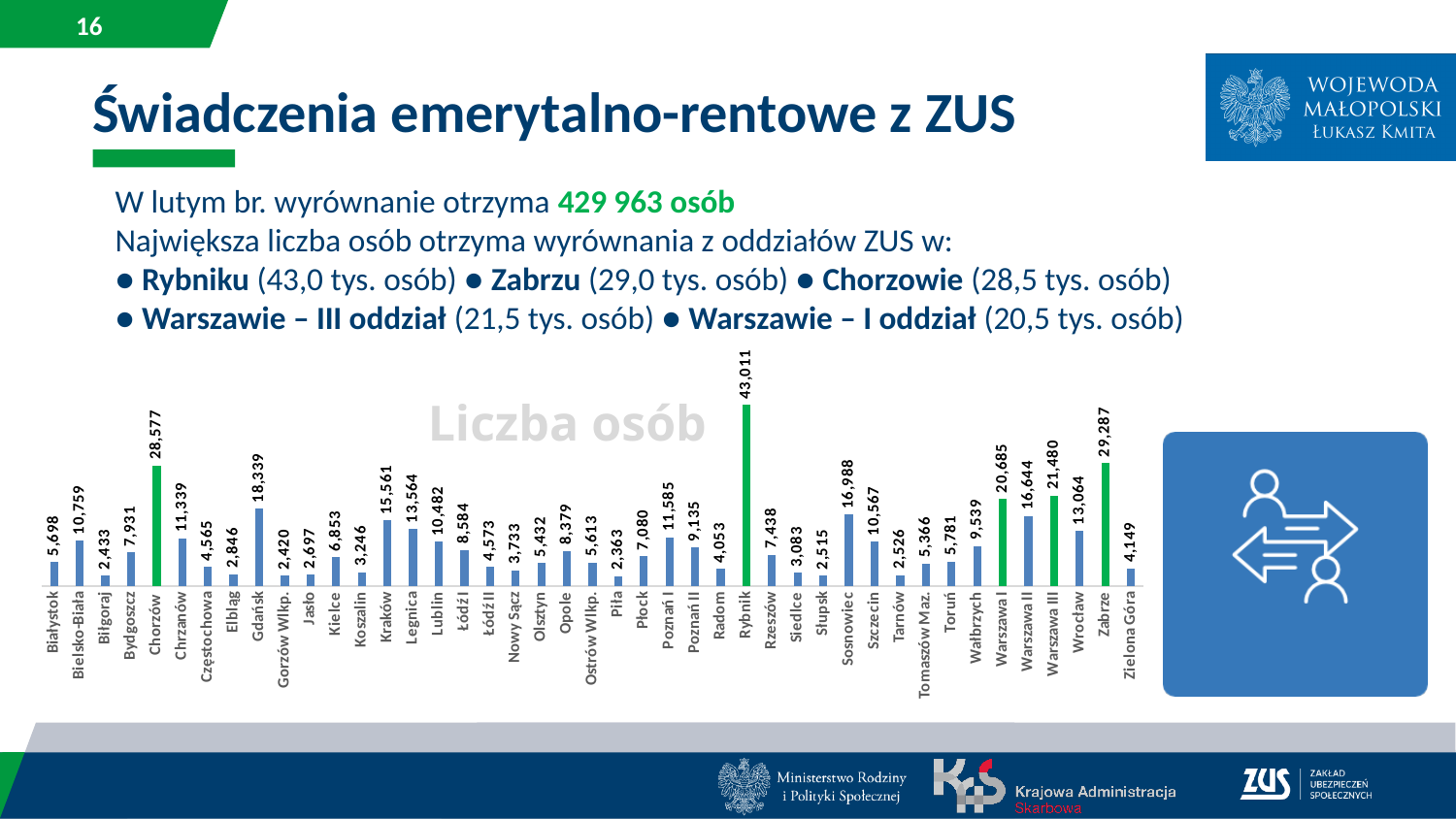
What is the difference between the values for Zabrze and Chorzów? 710 Which category has the highest value in the chart? Rybnik Which has a larger value, Gdańsk or Sosnowiec? Gdańsk What is the value for Kraków in the chart? 15,561 What is the value for Warszawa III in the chart? 21,480 What is the title of the chart? Liczba osób What type of chart is shown on the slide? bar chart How many bars in the chart are coloured green? 5 How many categories are shown in the chart? 43 Which category has the lowest value in the chart? Piła What is the difference between the values for Rybnik and Zabrze? 13,724 What is the value for Rybnik in the chart? 43,011